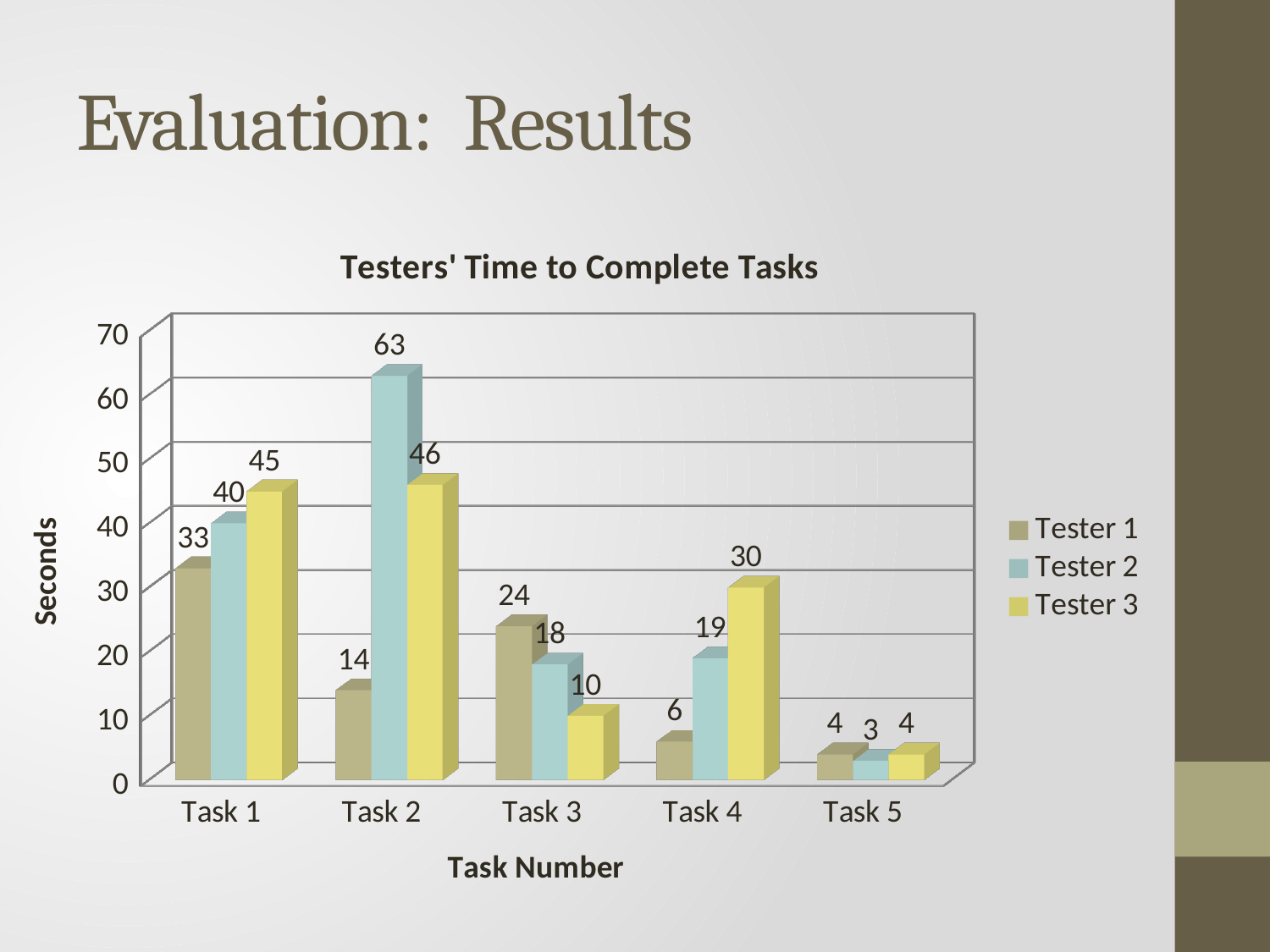
What is the difference between Tester 3 and Tester 1 on Task 2? 32 How many series does the legend list? 3 What kind of chart is shown on the slide? Bar chart Which task has the highest value for Tester 2? Task 2 Which is larger on Task 3: Tester 1 or Tester 2? Tester 1 What is the value for Tester 3 on Task 4? 30 What is the value for Tester 1 on Task 3? 24 What is the value for Tester 2 on Task 2? 63 How many tasks are shown on the x axis? 5 Is the value for Tester 2 on Task 1 greater or less than 30? greater Which task has the lowest value for Tester 1? Task 5 What is the title of the chart? Testers' Time to Complete Tasks